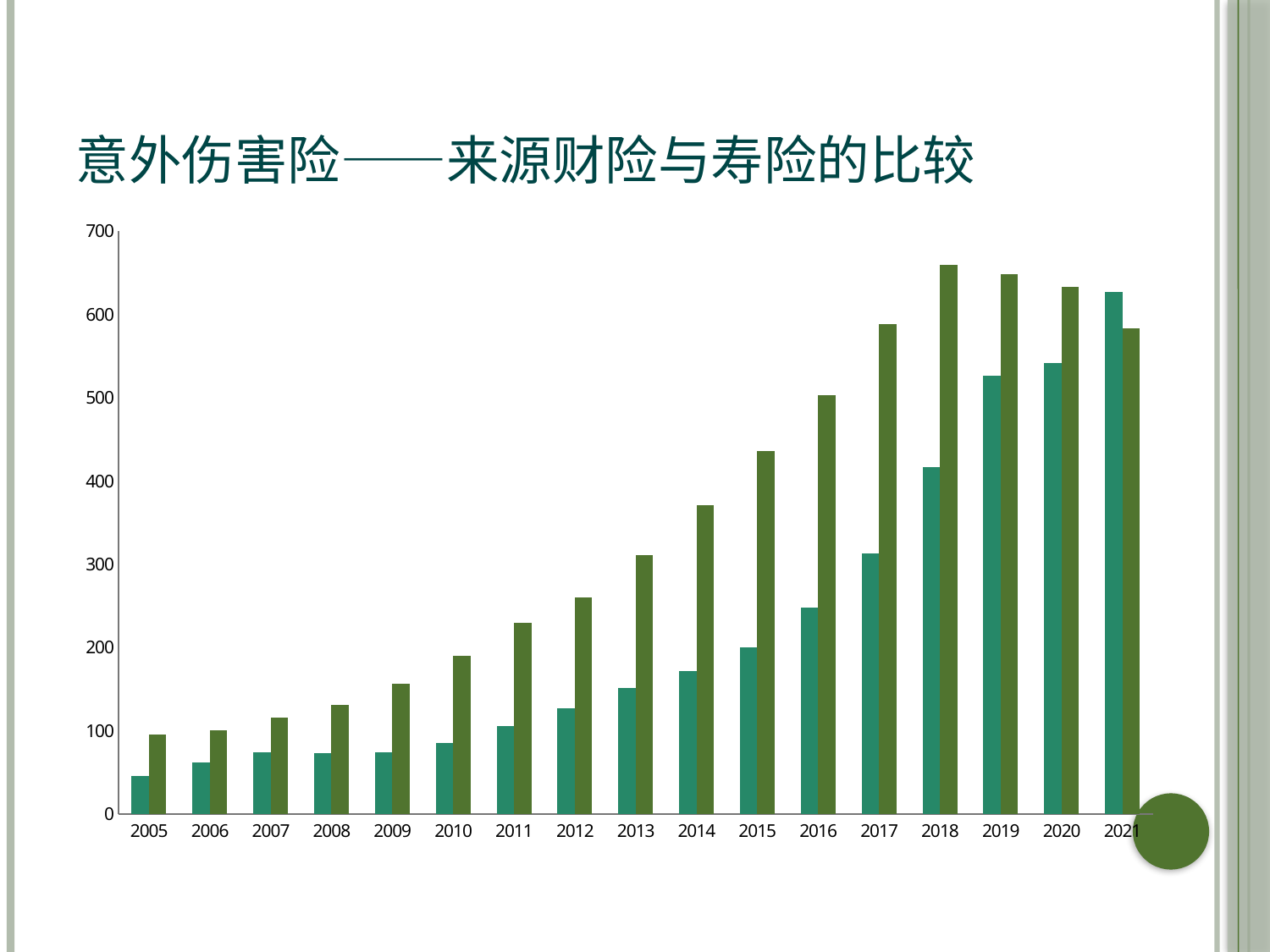
In which year is the teal (darker green) series at its lowest? 2005 What is the title of the slide containing the chart? 意外伤害险——来源财险与寿险的比较 In which year is the teal (darker green) series at its highest? 2021 Is the value of the olive green bar for 2014 greater or less than 300? greater How many data series are plotted for each year in the chart? 2 Does the teal (darker green) series generally rise or fall from 2005 to 2021? rise Is the value of the teal bar for 2016 greater or less than 300? less Is the value of the teal bar for 2018 greater or less than 400? greater In 2021, which bar is taller, the teal bar or the olive green bar? teal What kind of chart is shown on the slide? bar chart How many years are shown on the x axis of the chart? 17 In 2017, which bar is taller, the teal bar or the olive green bar? olive green